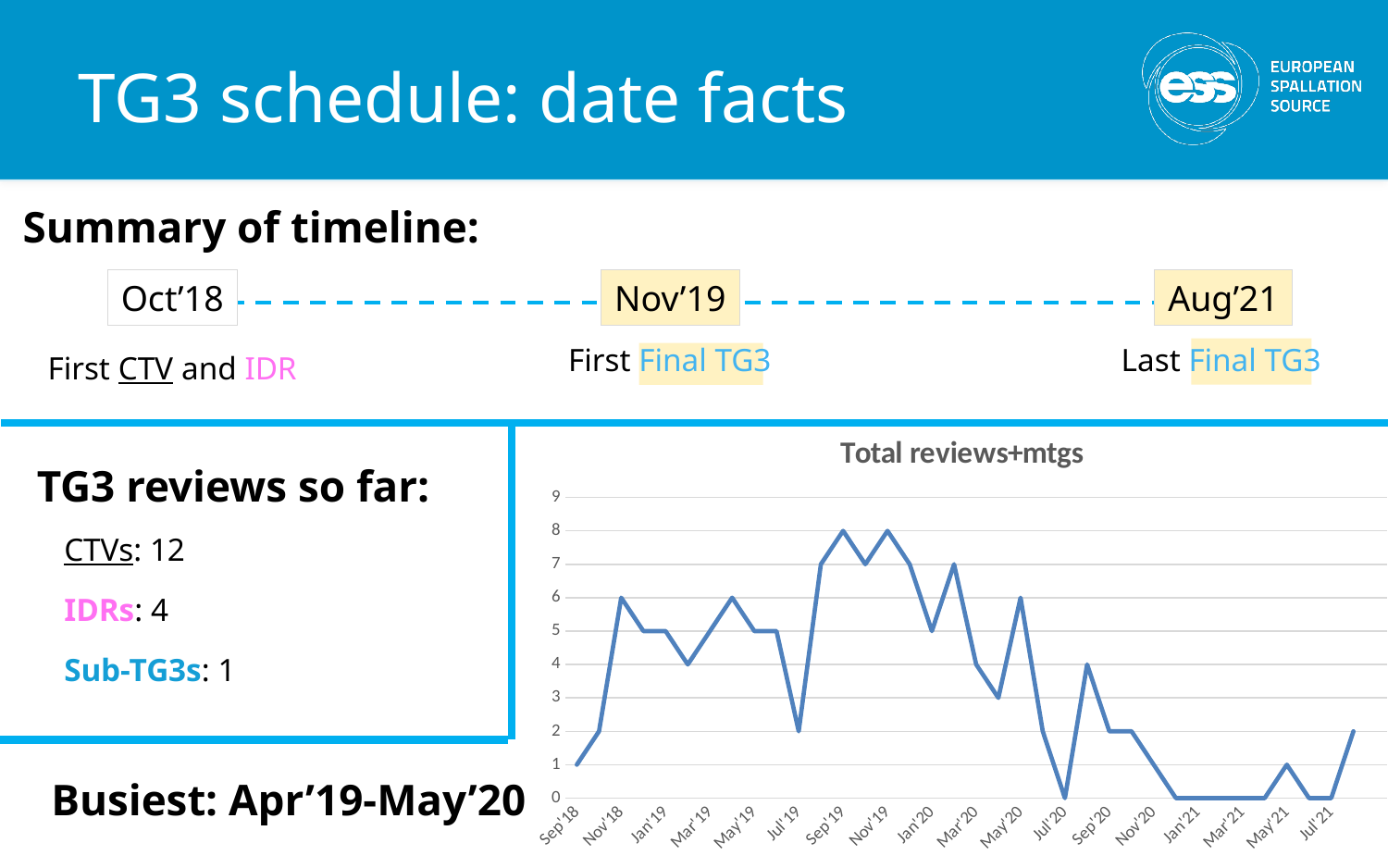
What is the difference between the values for Sep'19 and Jul'19? 6 What is the value plotted for Sep'18, the first point on the chart? 1 How many month labels are shown along the x axis? 18 What is the lowest value reached on the chart? 0 What is the value plotted for Sep'19? 8 What is the highest value reached on the chart? 8 Do the values generally rise or fall from Nov'19 to Jan'21? fall Is the value for Sep'19 greater or less than 5? greater What kind of chart is shown on the slide? line chart What is the title of the chart? Total reviews+mtgs What is the value plotted for Jul'20? 0 Which has the larger value, Nov'18 or Jul'19? Nov'18